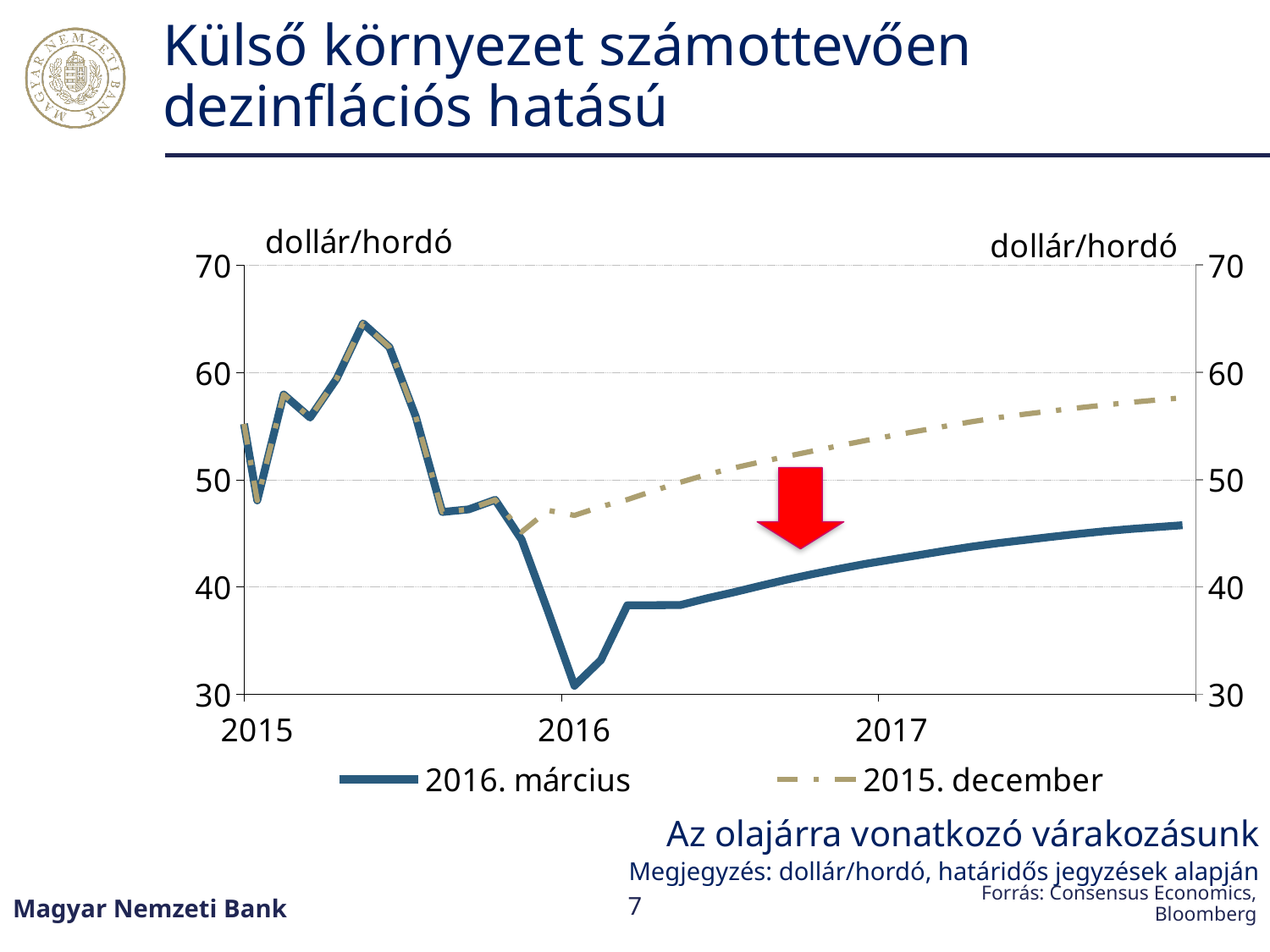
What is the maximum value shown on the y axis? 70 What is the caption below the chart describing what it shows? Az olajárra vonatkozó várakozásunk Is the highest point reached in 2015 greater or less than 60? greater How many series does the legend list? 2 At the end of 2017, is the value of the 2016. március series greater or less than 50? less How many year labels are shown on the x axis? 3 At the end of 2017, which series is higher: 2016. március or 2015. december? 2015. december At the end of 2017, is the value of the 2015. december series greater or less than 50? greater What are the two series named in the legend? 2016. március and 2015. december What kind of chart is shown on the slide? line chart Does the 2016. március series rise or fall from early 2016 to the end of 2017? rise